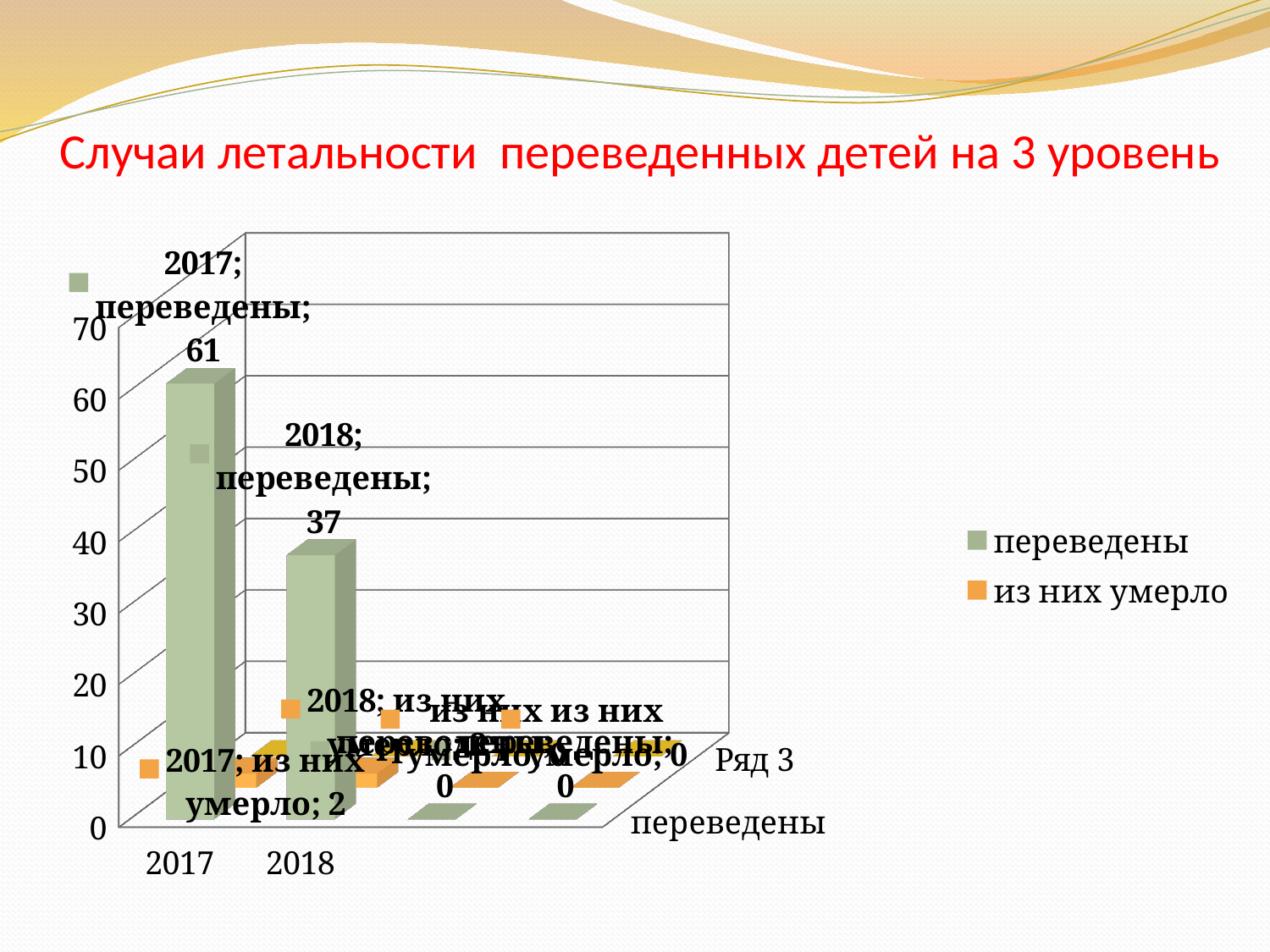
What is the value for 'из них умерло' in 2017? 2 Which year has the lower value for 'переведены'? 2018 How many years are shown on the x axis? 2 Is the 'переведены' value for 2017 larger or smaller than the 'переведены' value for 2018? larger What is the value for 'переведены' in 2017? 61 What is the difference between the 'переведены' values for 2017 and 2018? 24 What is the title of the slide's chart? Случаи летальности переведенных детей на 3 уровень What is the value for 'переведены' in 2018? 37 Which year has the higher value for 'переведены'? 2017 Is the value for 'переведены' in 2018 greater or less than 40? less What kind of chart is shown on the slide? bar chart How many series does the legend list? 2